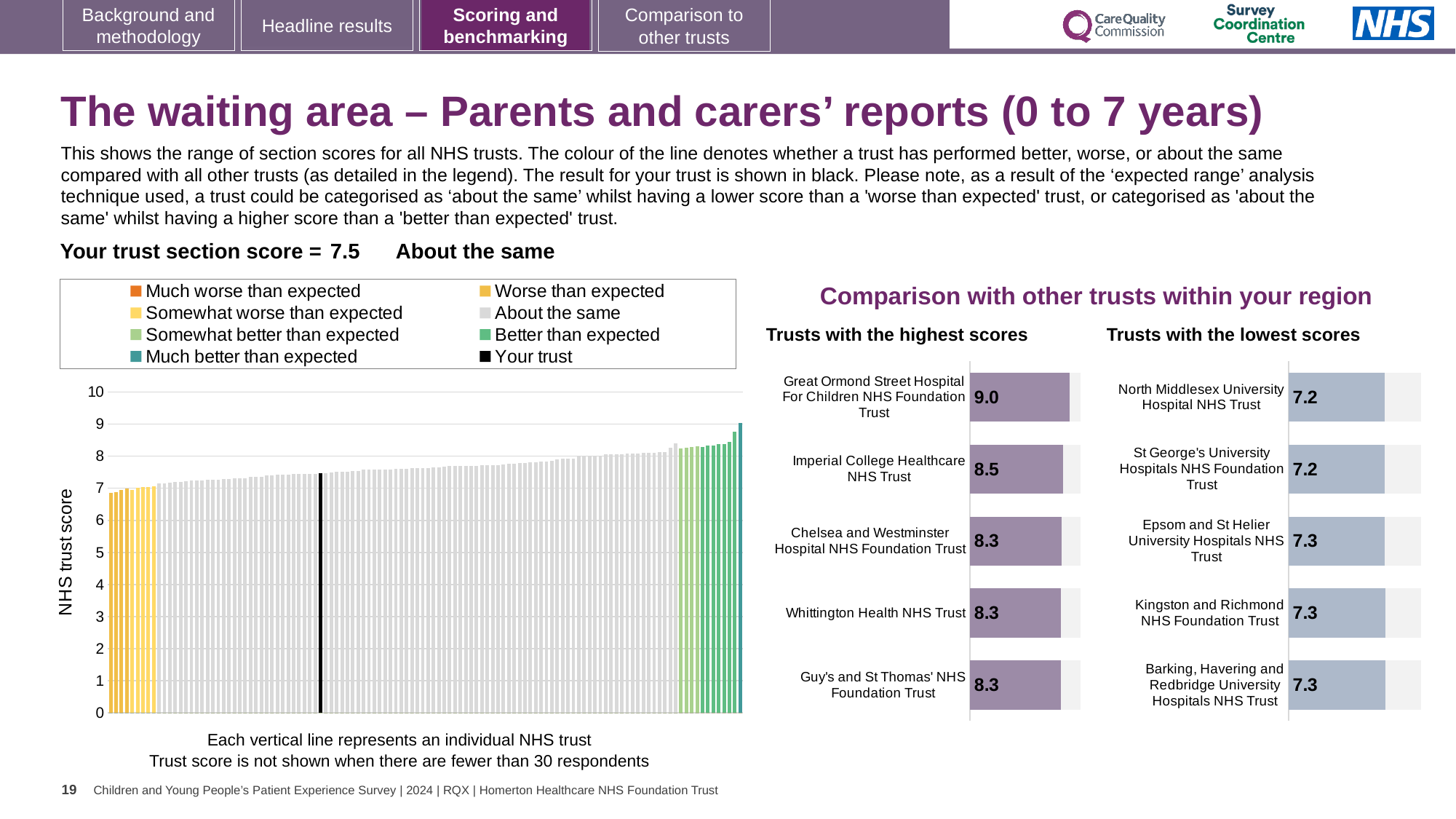
In the 'Trusts with the lowest scores' chart, which is larger: the score for Barking, Havering and Redbridge University Hospitals NHS Trust or the score for North Middlesex University Hospital NHS Trust? Barking, Havering and Redbridge University Hospitals NHS Trust In the 'Trusts with the lowest scores' chart, what is the score for Kingston and Richmond NHS Foundation Trust? 7.3 In the 'Trusts with the highest scores' chart, what is the difference between the scores of Great Ormond Street Hospital For Children NHS Foundation Trust and Imperial College Healthcare NHS Trust? 0.5 In the 'Trusts with the highest scores' chart, which trust has the highest score? Great Ormond Street Hospital For Children NHS Foundation Trust How many entries does the legend of the main chart on the left list? 8 In the 'Trusts with the lowest scores' chart, what is the difference between the scores of Epsom and St Helier University Hospitals NHS Trust and St George's University Hospitals NHS Foundation Trust? 0.1 In the 'Trusts with the highest scores' chart, how many trusts are listed? 5 In the 'Trusts with the highest scores' chart, what is the score for Imperial College Healthcare NHS Trust? 8.5 In the main chart on the left showing all NHS trusts, what is the section score for your trust (the black bar)? 7.5 In the main chart on the left showing all NHS trusts, do the trust scores rise or fall from left to right? rise In the 'Trusts with the highest scores' chart, what is the score for Great Ormond Street Hospital For Children NHS Foundation Trust? 9.0 In the 'Trusts with the lowest scores' chart, what is the score for North Middlesex University Hospital NHS Trust? 7.2